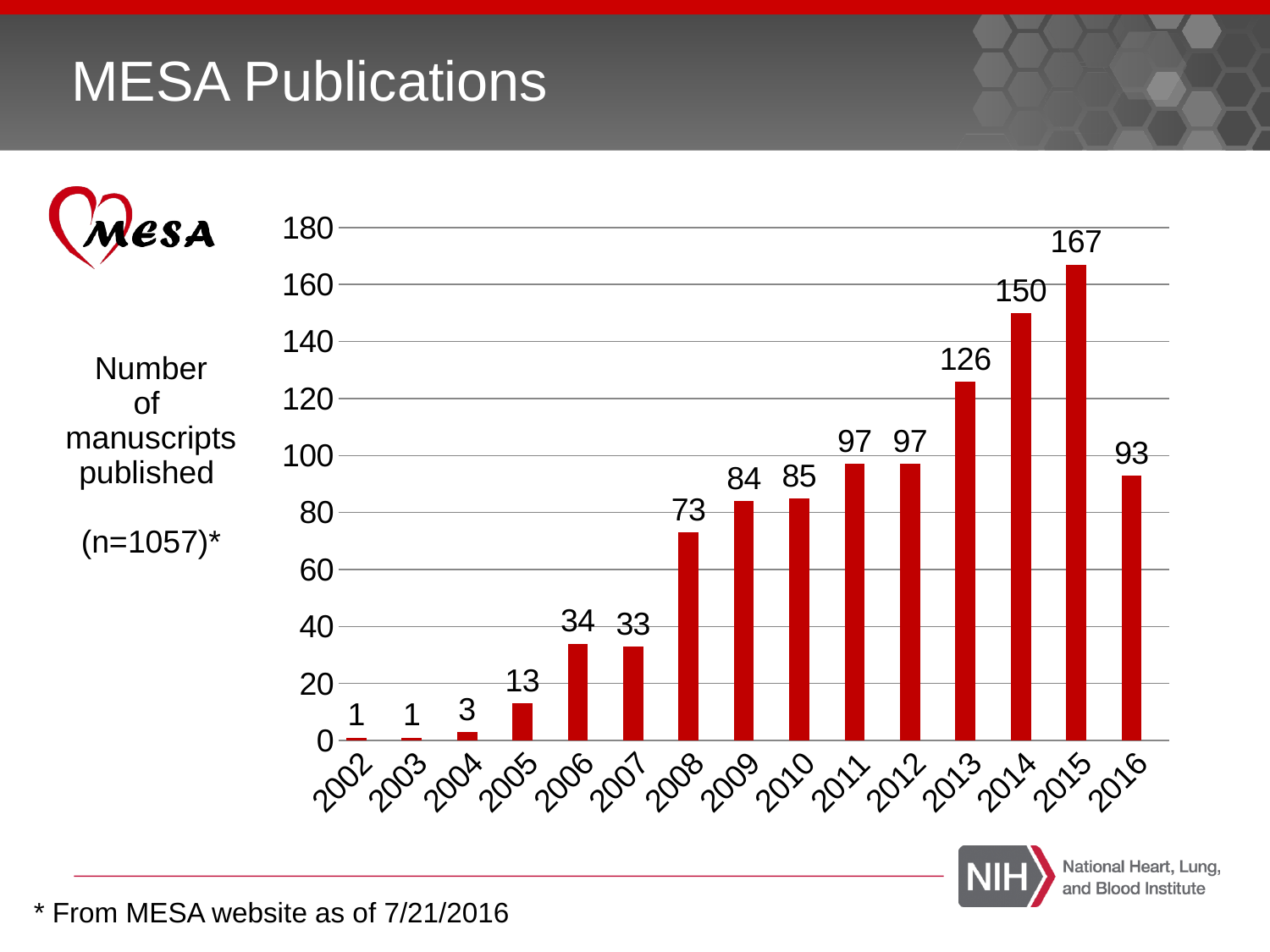
Is the value for 2016 greater or less than 100? less What is the value shown for 2008? 73 Which is larger, the value for 2006 or the value for 2007? 2006 How many manuscripts were published in 2013? 126 What is the difference between the values for 2015 and 2014? 17 What is the title of the slide? MESA Publications How many years are shown on the x axis? 15 What is the total number of manuscripts published stated on the slide? 1057 What kind of chart is shown on the slide? bar chart Do the values generally rise or fall from 2002 to 2015? rise What is the value shown for 2005? 13 Which year has the highest number of manuscripts published? 2015